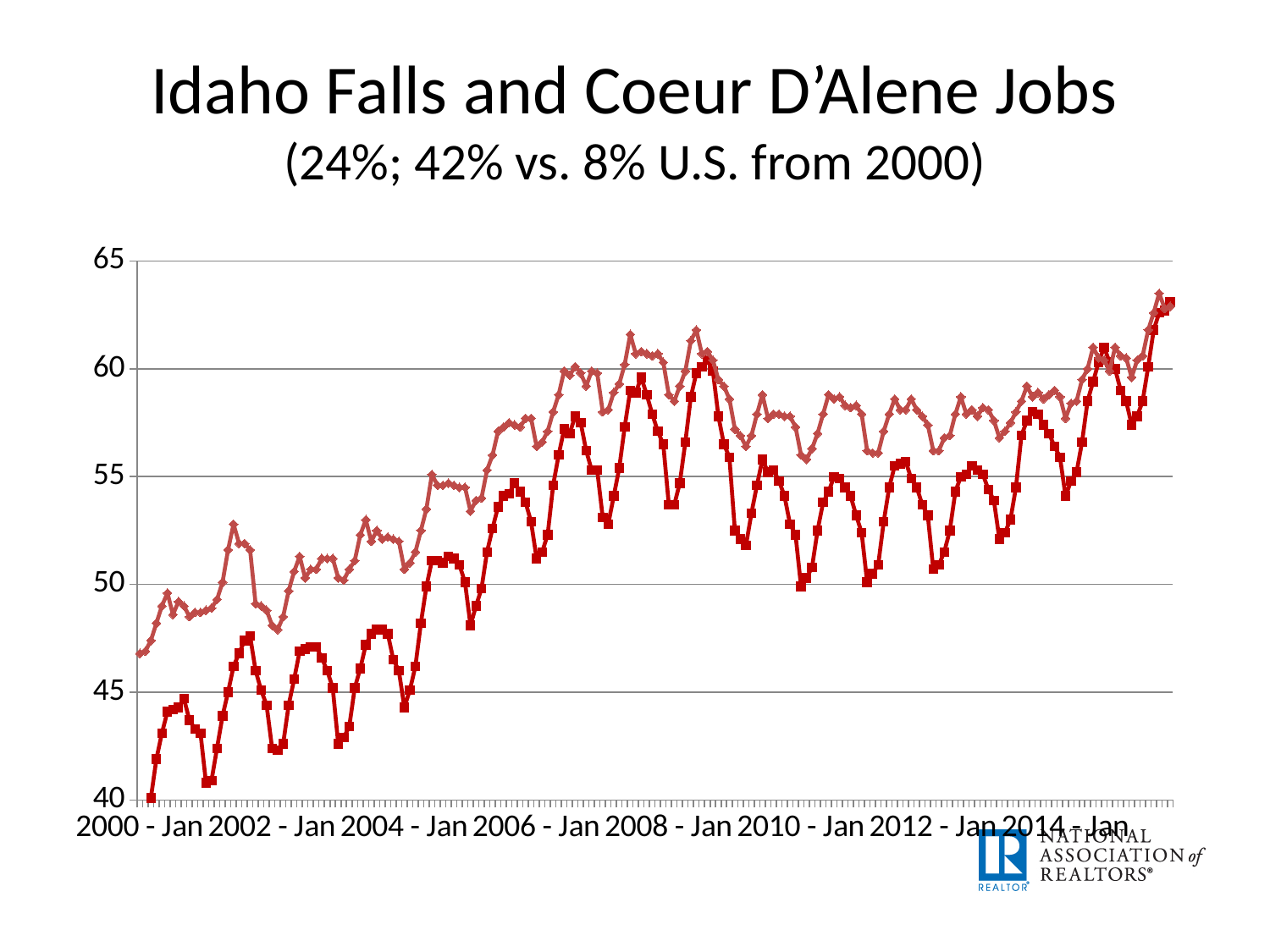
Is the value of the upper line (diamond markers) at 2008 - Jan greater or less than 55? greater How many lines are plotted on the chart? 2 At 2000 - Jan, which line has the larger value, the line with diamond markers or the line with square markers? the line with diamond markers What is the first label shown on the x axis? 2000 - Jan What is the title of the chart? Idaho Falls and Coeur D'Alene Jobs (24%; 42% vs. 8% U.S. from 2000) What kind of chart is shown on the slide? line chart Is the value of the lower line (square markers) at 2014 - Jan greater or less than 60? less Is the value of the upper line (diamond markers) at 2000 - Jan greater or less than 45? greater Do the values of the lower line (square markers) generally rise or fall from 2000 - Jan to 2014 - Jan? rise